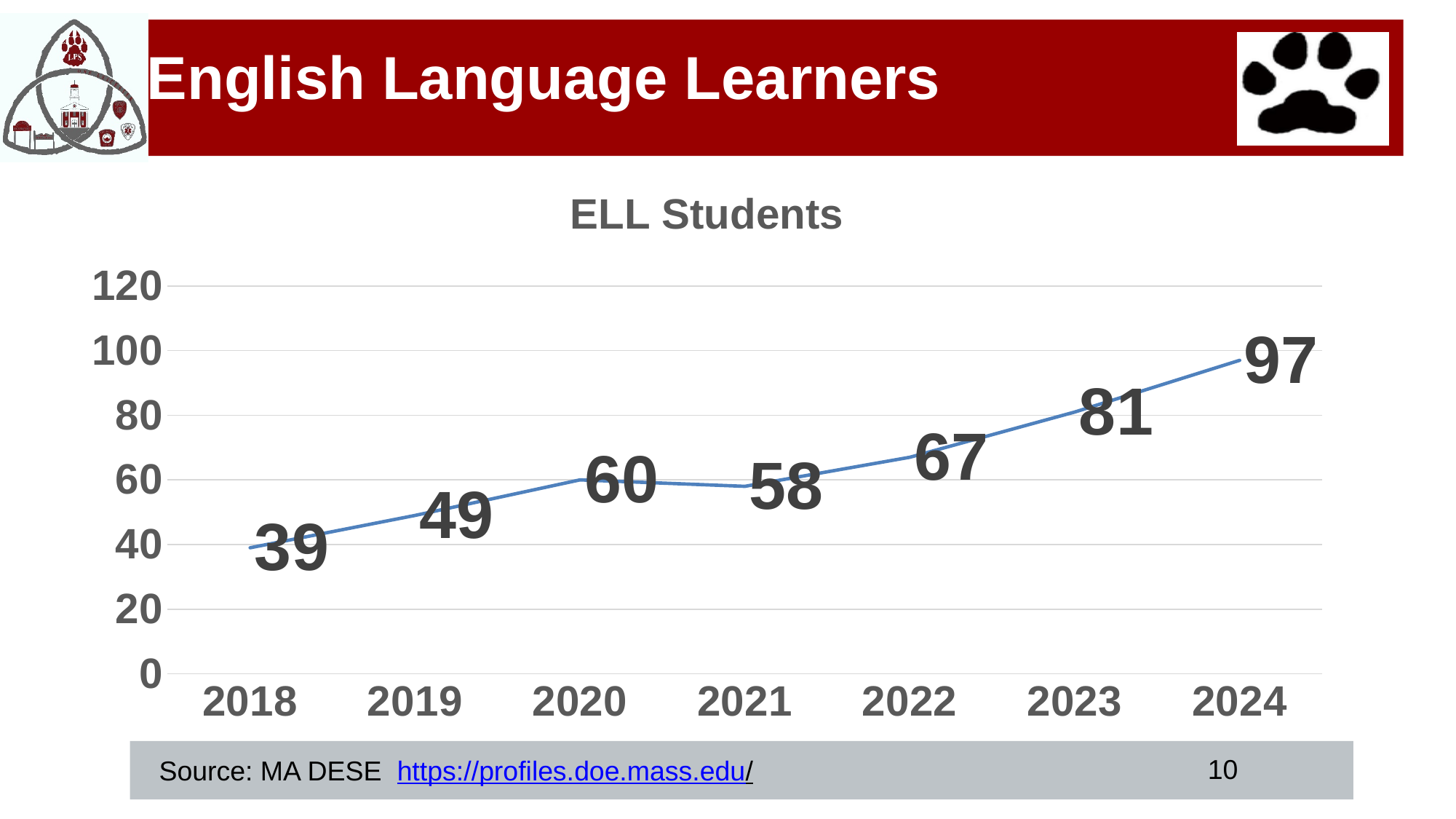
What is the number of ELL students in 2018? 39 What kind of chart is shown on the slide? Line chart What is the difference in ELL students between 2024 and 2018? 58 What is the title of the chart? ELL Students What is the difference in ELL students between 2023 and 2022? 14 What is the number of ELL students in 2021? 58 Is the value for 2023 greater or less than 80? greater How many years are plotted on the chart? 7 Which year has the highest number of ELL students? 2024 What is the number of ELL students in 2024? 97 Which year has more ELL students, 2020 or 2021? 2020 Which year has the lowest number of ELL students? 2018